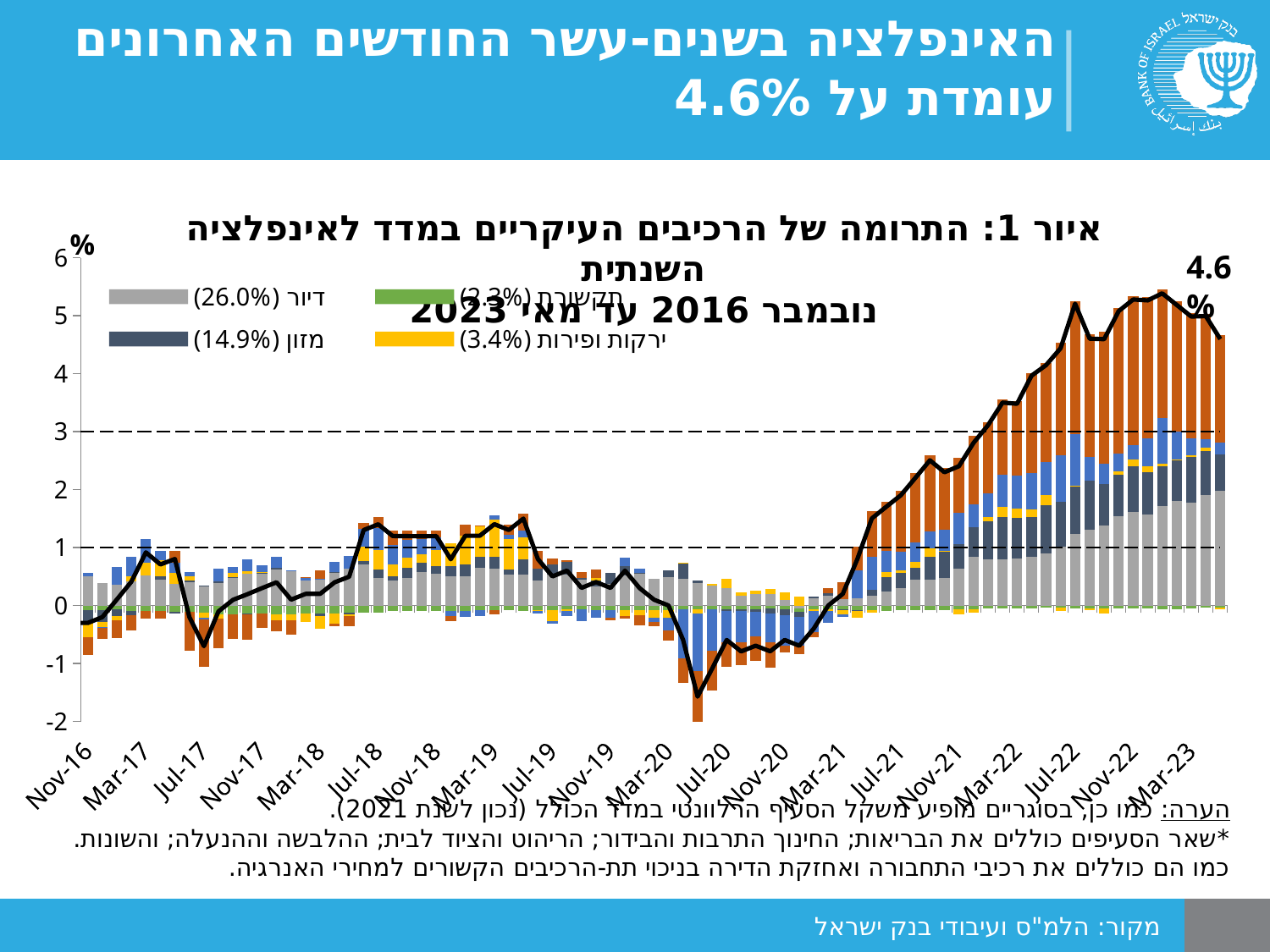
Which legend component has the largest weight shown in parentheses? דיור (26.0%) Is the value of the line at Nov-22 greater or less than 4? greater What kind of chart is shown on the slide? stacked bar chart with a line What weight is shown in the legend for מזון (food)? 14.9% Is the value of the line at Jul-17 greater or less than 0? less What weight is shown in the legend for דיור (housing)? 26.0% Which legend component has the smallest weight shown in parentheses? תקשורת (2.3%) Is the value of the line at Jul-20 greater or less than -1? greater What is the annual inflation value labelled at the end of the line (May 2023)? 4.6% What weight is shown in the legend for ירקות ופירות (vegetables and fruit)? 3.4% Which is higher, the line value at Mar-23 or at Mar-20? Mar-23 Between Mar-21 and Nov-22, does the line rise or fall? rise